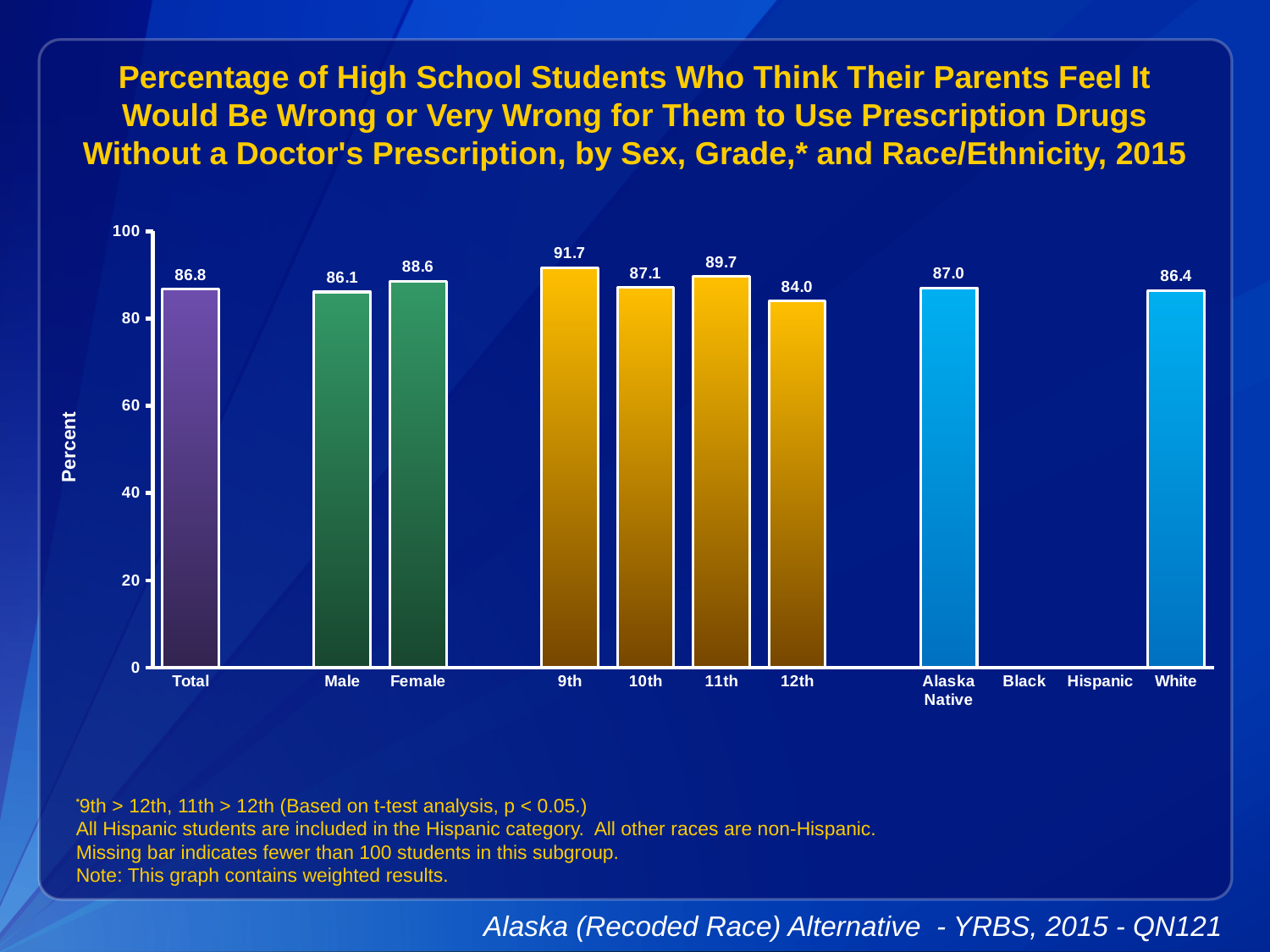
What kind of chart is shown on the slide? bar chart What is the value for 12th grade? 84.0 What is the value for Total? 86.8 Which category has the lowest value among the bars shown? 12th What is the difference between the Female and Male values? 2.5 Which race/ethnicity categories have no bar shown? Black and Hispanic Is the value for White greater or less than 80? greater How many bars are plotted on the chart? 9 What is the value for Alaska Native? 87.0 What is the value for Female? 88.6 Which is larger, the value for 9th grade or the value for 11th grade? 9th Which category has the highest value? 9th